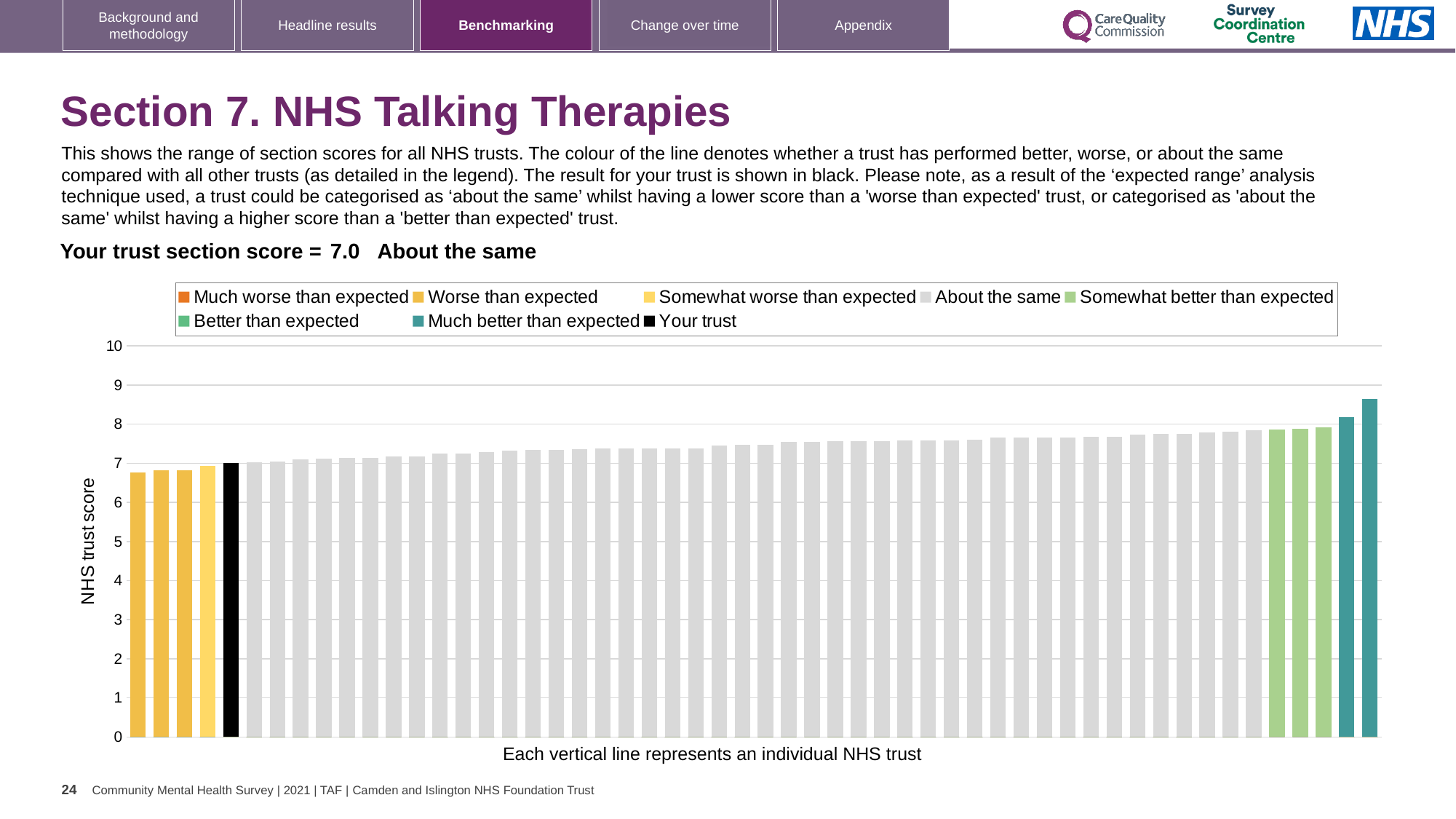
Which legend category does the tallest bar in the chart belong to? Much better than expected What colour is the bar representing your trust? Black Which benchmarking category is your trust placed in for this section? About the same Is the value of the tallest bar in the chart greater or less than 9? less What kind of chart is shown on the slide? Bar chart Is the value of the tallest bar in the chart greater or less than 8? greater How many bars are coloured as 'Much better than expected'? 2 How many entries does the chart legend list? 8 Do the bar values rise or fall moving from left to right along the x axis? Rise What is the label on the y axis of the chart? NHS trust score Is the value of the shortest bar in the chart greater or less than 7? less What is the section score for your trust shown on the slide? 7.0